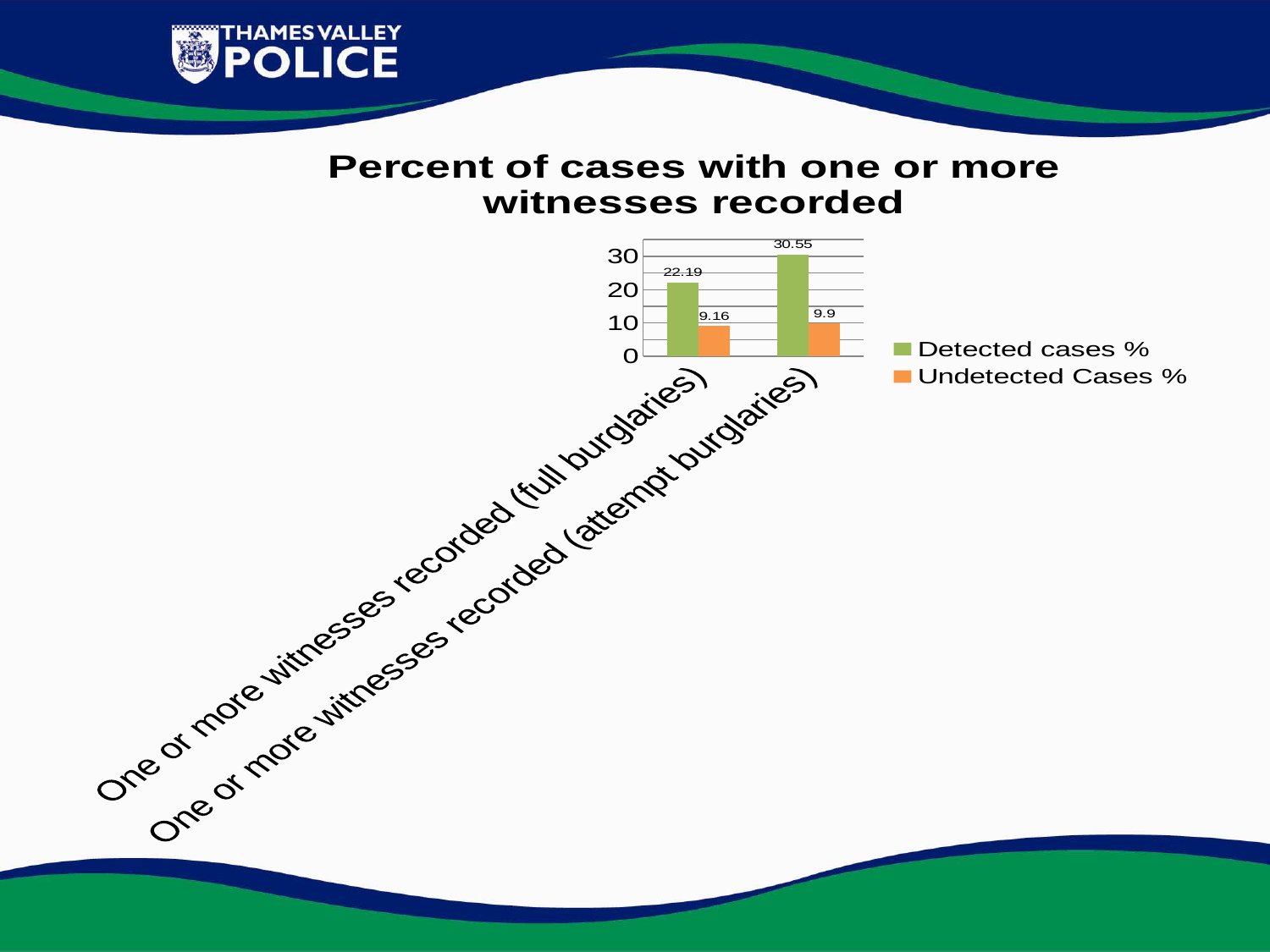
For full burglaries, which is larger: Detected cases % or Undetected Cases %? Detected cases % What is the Undetected Cases % value for 'One or more witnesses recorded (full burglaries)'? 9.16 Is the Detected cases % value for attempt burglaries greater or less than 30? greater What is the Detected cases % value for 'One or more witnesses recorded (full burglaries)'? 22.19 What is the Undetected Cases % value for 'One or more witnesses recorded (attempt burglaries)'? 9.9 What is the Detected cases % value for 'One or more witnesses recorded (attempt burglaries)'? 30.55 Which bar has the lowest value on the chart? Undetected Cases % for One or more witnesses recorded (full burglaries) How many series does the legend list? 2 How many categories are shown on the x axis? 2 What type of chart is shown on the slide? Bar chart What is the difference between the Detected cases % values for attempt burglaries and full burglaries? 8.36 Which category has the highest Detected cases % value? One or more witnesses recorded (attempt burglaries)